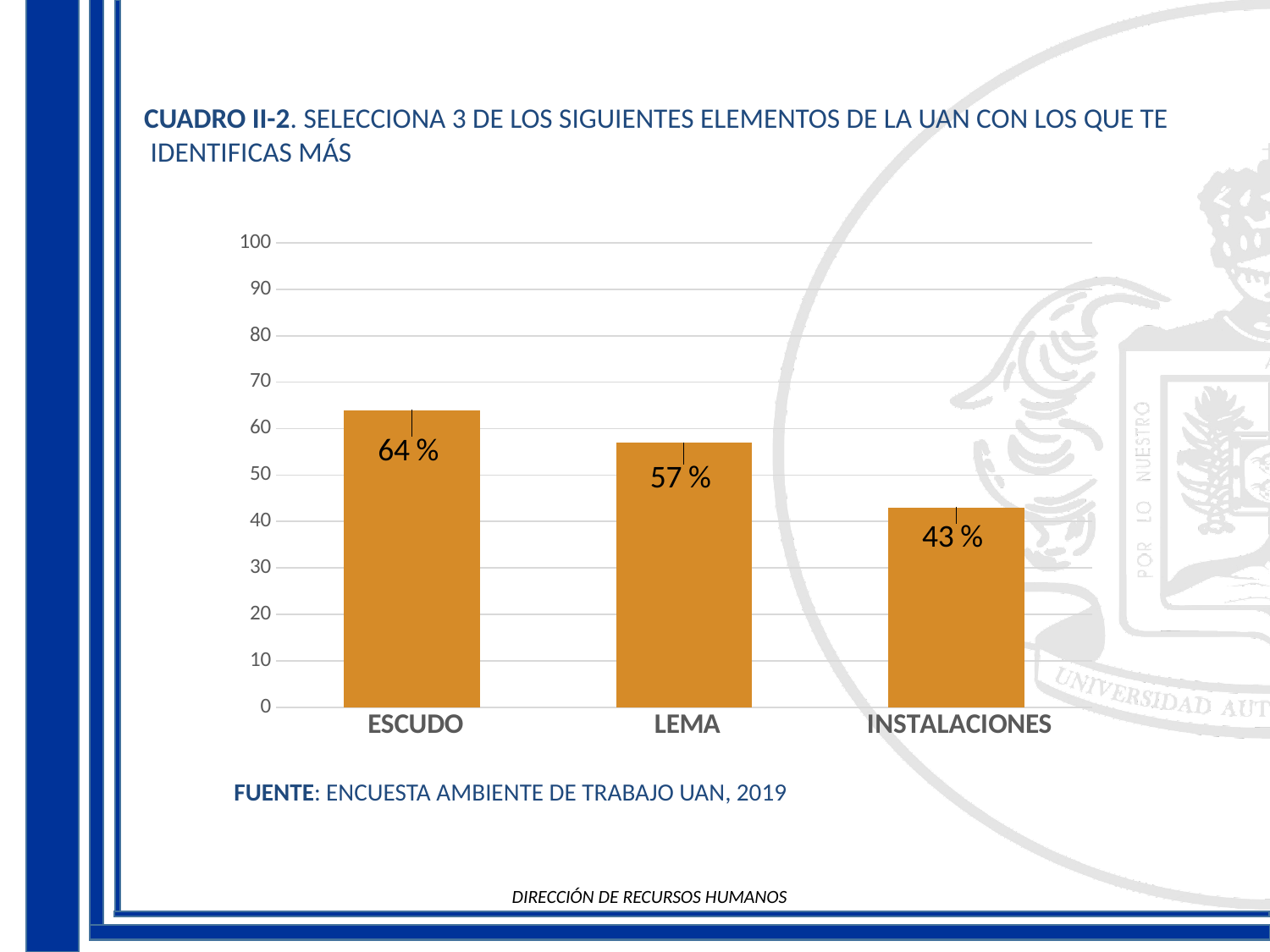
Is the value for LEMA greater or less than 50? greater What is the difference between the values for ESCUDO and INSTALACIONES? 21 % How many categories are shown on the x axis? 3 What is the difference between the values for ESCUDO and LEMA? 7 % What is the value for INSTALACIONES? 43 % What kind of chart is shown on the slide? bar chart What is the value for ESCUDO? 64 % Do the values rise or fall from left to right along the x axis? fall Which category has the highest value? ESCUDO What is the value for LEMA? 57 % Which category has the lowest value? INSTALACIONES Which is larger, the value for LEMA or the value for INSTALACIONES? LEMA